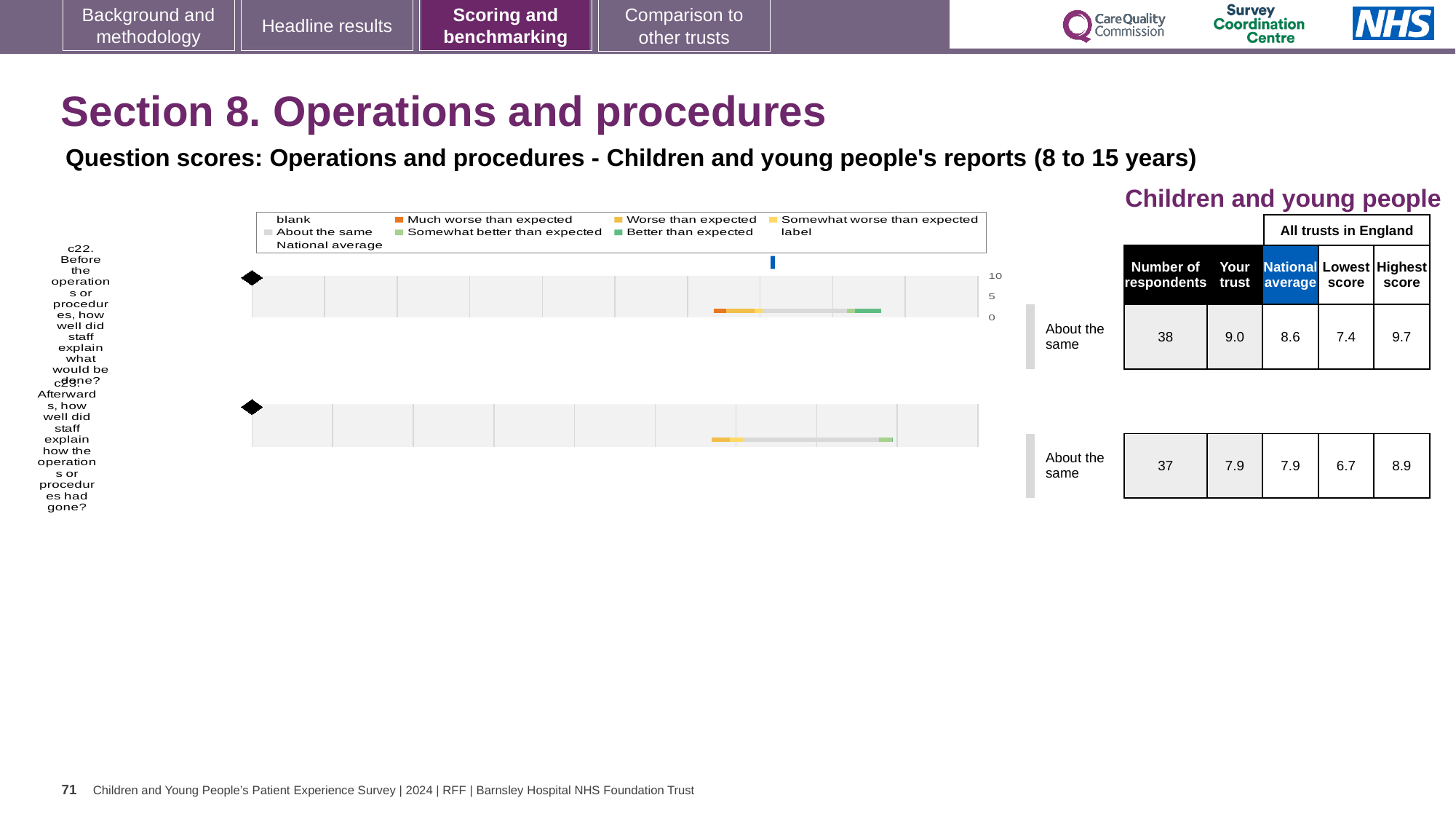
What is the difference between the 'Your trust' score and the national average for question c22? 0.4 For question c22, which is larger: the 'Your trust' score or the national average? Your trust Is the 'Your trust' score for question c23 greater or less than 5 on the chart axis? greater For question c23 (Afterwards, how well did staff explain how the operations or procedures had gone?), what is the highest score among all trusts in England? 8.9 What benchmark category is shown for question c22? About the same What is the difference between the highest and lowest scores for question c23? 2.2 How many questions (categories) are plotted in the charts on this slide? 2 How many entries does the chart legend list? 9 What kind of chart is used to show the question scores on this slide? bar chart How many respondents answered question c23? 37 For question c22 (Before the operations or procedures, how well did staff explain what would be done?), what is the 'Your trust' score? 9.0 For question c22, what is the national average score? 8.6